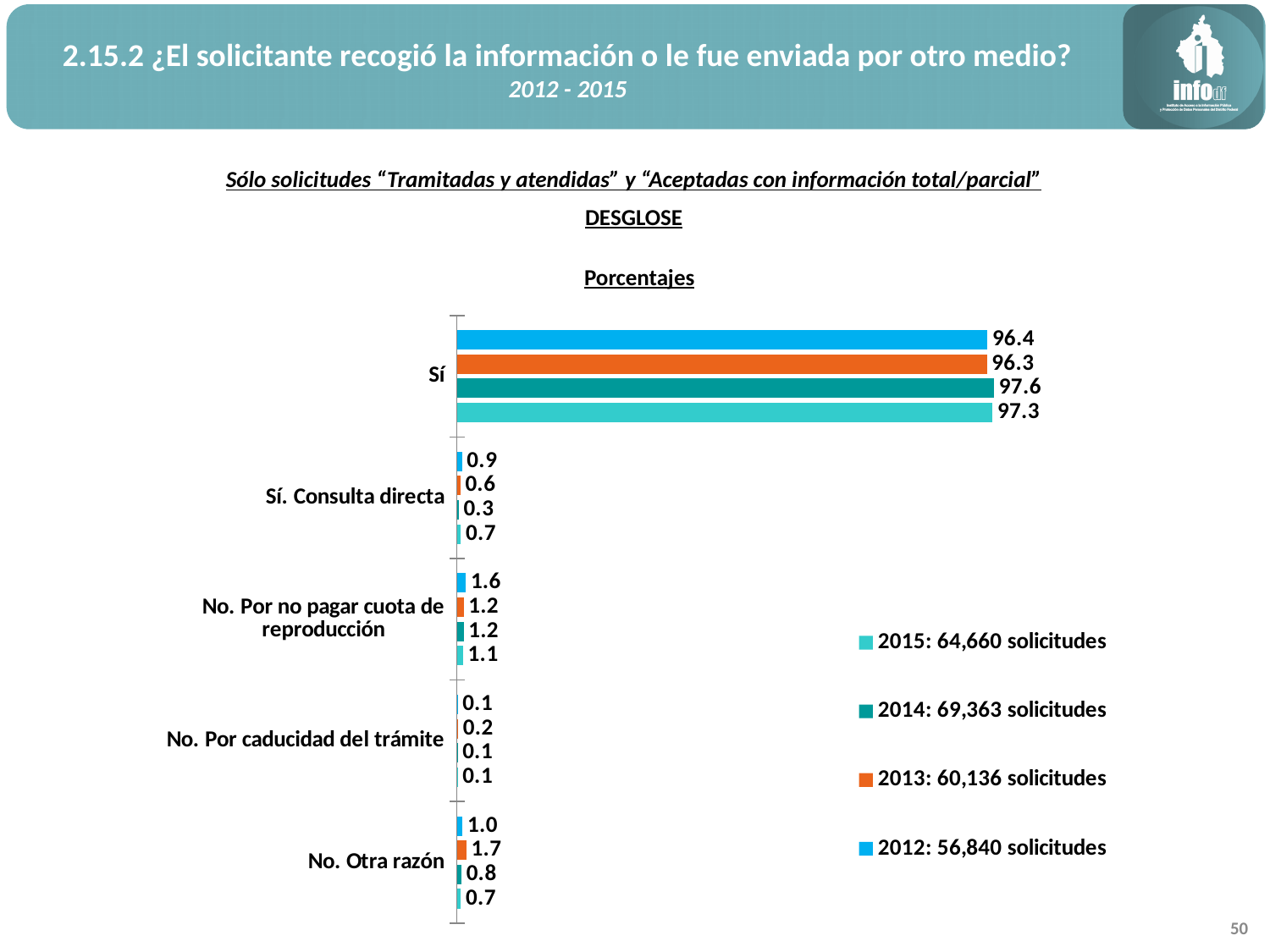
How many categories are shown on the chart? 5 Which category has the highest value in the 2015 series? Sí What is the value for "No. Otra razón" in the 2013 series? 1.7 What is the value for "Sí" in the 2014 series? 97.6 According to the legend, how many solicitudes were there in 2014? 69,363 solicitudes What is the difference between the 2013 and 2014 values for "No. Otra razón"? 0.9 How many series does the legend list? 4 What is the difference between the 2014 and 2013 values for "Sí"? 1.3 What is the value for "Sí. Consulta directa" in the 2012 series? 0.9 Which is larger for "No. Por no pagar cuota de reproducción": the 2012 value or the 2015 value? 2012 What type of chart is shown on the slide? bar chart Which category has the lowest value in the 2013 series? No. Por caducidad del trámite